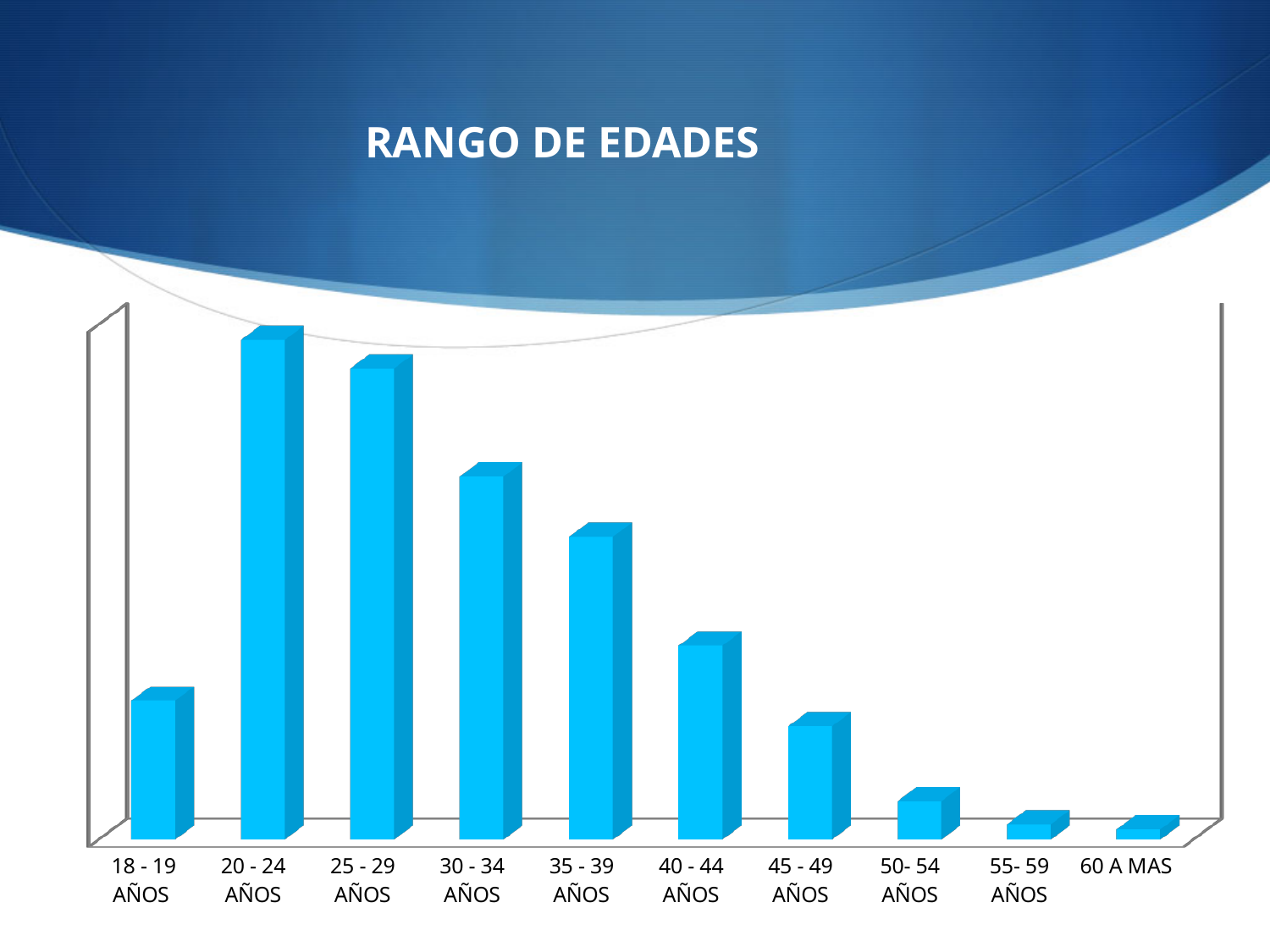
What kind of chart is shown on the slide? Bar chart What colour are the bars in the chart? Light blue What is the title of the chart? RANGO DE EDADES Which age range has the second highest bar? 25 - 29 AÑOS Which age range has the highest bar? 20 - 24 AÑOS From 20 - 24 AÑOS to 60 A MAS, do the bar values rise or fall along the x axis? Fall How many age categories are shown on the x axis? 10 Which is larger, the bar for 18 - 19 AÑOS or the bar for 40 - 44 AÑOS? 40 - 44 AÑOS Which age range has the lowest bar? 60 A MAS Which is larger, the bar for 25 - 29 AÑOS or the bar for 30 - 34 AÑOS? 25 - 29 AÑOS Which is larger, the bar for 45 - 49 AÑOS or the bar for 50- 54 AÑOS? 45 - 49 AÑOS